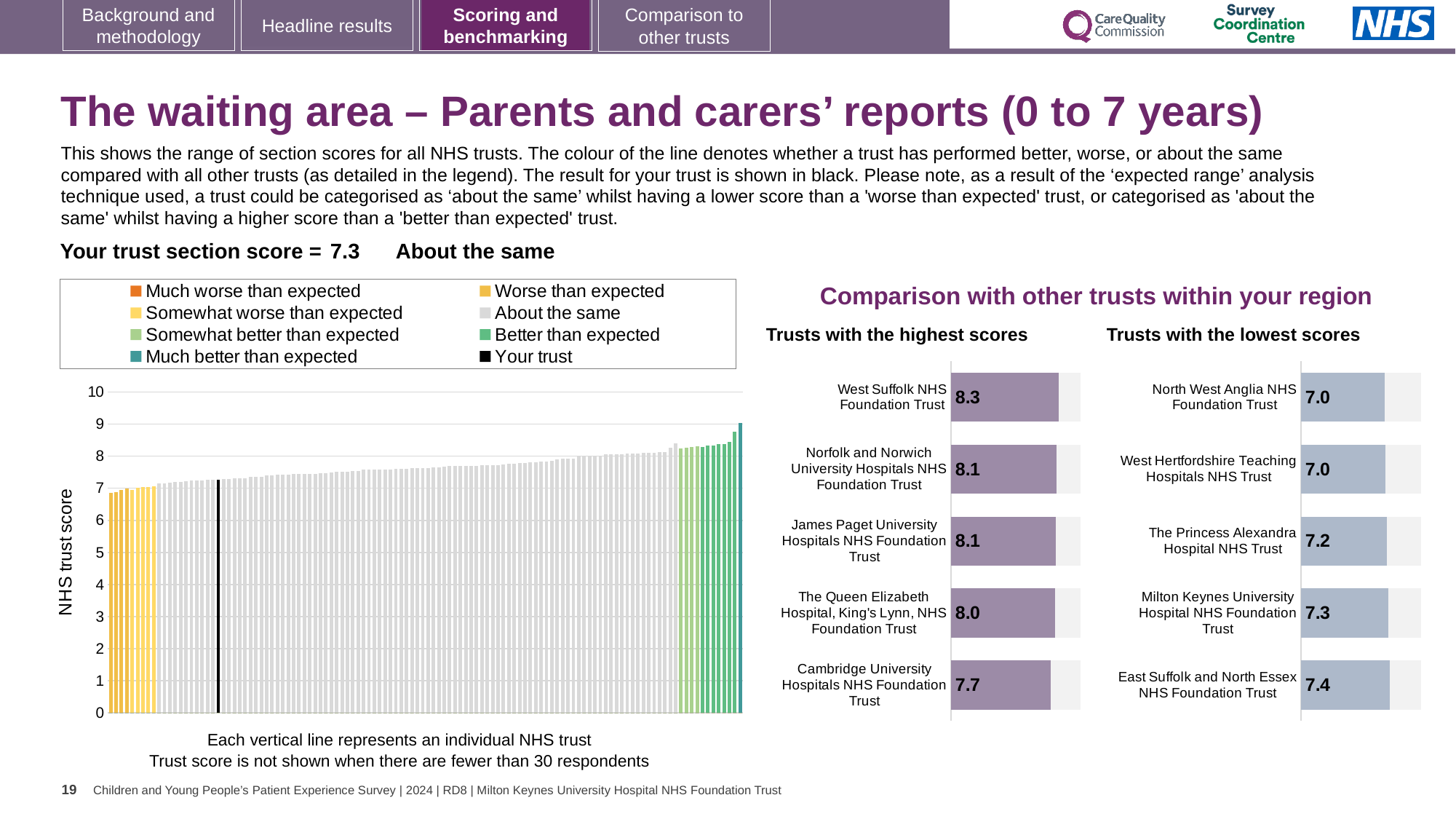
In the 'Trusts with the highest scores' chart, what is the score for West Suffolk NHS Foundation Trust? 8.3 In the 'Trusts with the lowest scores' chart, which trust has the highest score? East Suffolk and North Essex NHS Foundation Trust In the 'Trusts with the lowest scores' chart, what is the score for The Princess Alexandra Hospital NHS Trust? 7.2 What is the y-axis label of the large chart on the left? NHS trust score In the 'Trusts with the highest scores' chart, what is the score for Cambridge University Hospitals NHS Foundation Trust? 7.7 In the 'Trusts with the highest scores' chart, what is the difference between the scores of West Suffolk NHS Foundation Trust and Cambridge University Hospitals NHS Foundation Trust? 0.6 In the large chart on the left, is the value of the black bar (your trust) greater or less than 5? greater In the 'Trusts with the highest scores' chart, which trust has the highest score? West Suffolk NHS Foundation Trust In the 'Trusts with the highest scores' chart, which trust has the lowest score? Cambridge University Hospitals NHS Foundation Trust How many trusts are shown in the 'Trusts with the lowest scores' chart? 5 What kind of chart is the large chart on the left showing all NHS trusts? Bar chart In the 'Trusts with the lowest scores' chart, which has the larger score: Milton Keynes University Hospital NHS Foundation Trust or The Princess Alexandra Hospital NHS Trust? Milton Keynes University Hospital NHS Foundation Trust